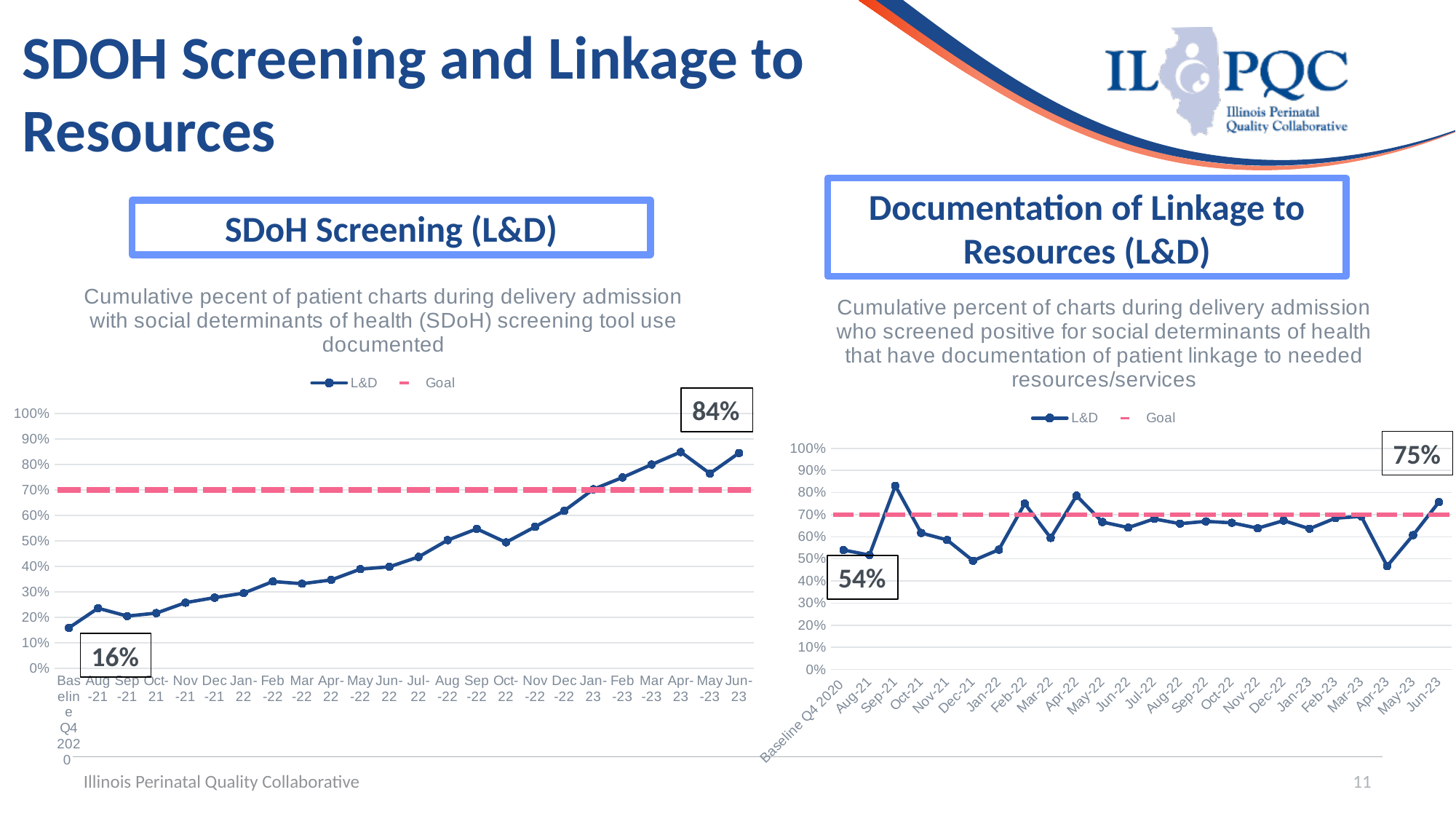
In the SDoH Screening (L&D) chart, what is the L&D value for Jun-23? 84% What type of chart is the SDoH Screening (L&D) chart? Line chart In the SDoH Screening (L&D) chart, what is the L&D value at Baseline Q4 2020? 16% In the SDoH Screening (L&D) chart, by how many percentage points did the L&D value increase from Baseline Q4 2020 to Jun-23? 68 percentage points In the Documentation of Linkage to Resources (L&D) chart, what is the L&D value at Baseline Q4 2020? 54% In the SDoH Screening (L&D) chart, does the L&D line generally rise or fall from Baseline Q4 2020 to Jun-23? Rise In the Documentation of Linkage to Resources (L&D) chart, is the L&D value for Apr-23 greater or less than 60%? less In the Documentation of Linkage to Resources (L&D) chart, what is the L&D value for Jun-23? 75% In the Documentation of Linkage to Resources (L&D) chart, what is the difference between the Jun-23 value and the Baseline Q4 2020 value? 21 percentage points In the Documentation of Linkage to Resources (L&D) chart, which month has the highest L&D value? Sep-21 In the SDoH Screening (L&D) chart, is the L&D value for Mar-22 greater or less than 40%? less How many series does the legend of the Documentation of Linkage to Resources (L&D) chart list? 2